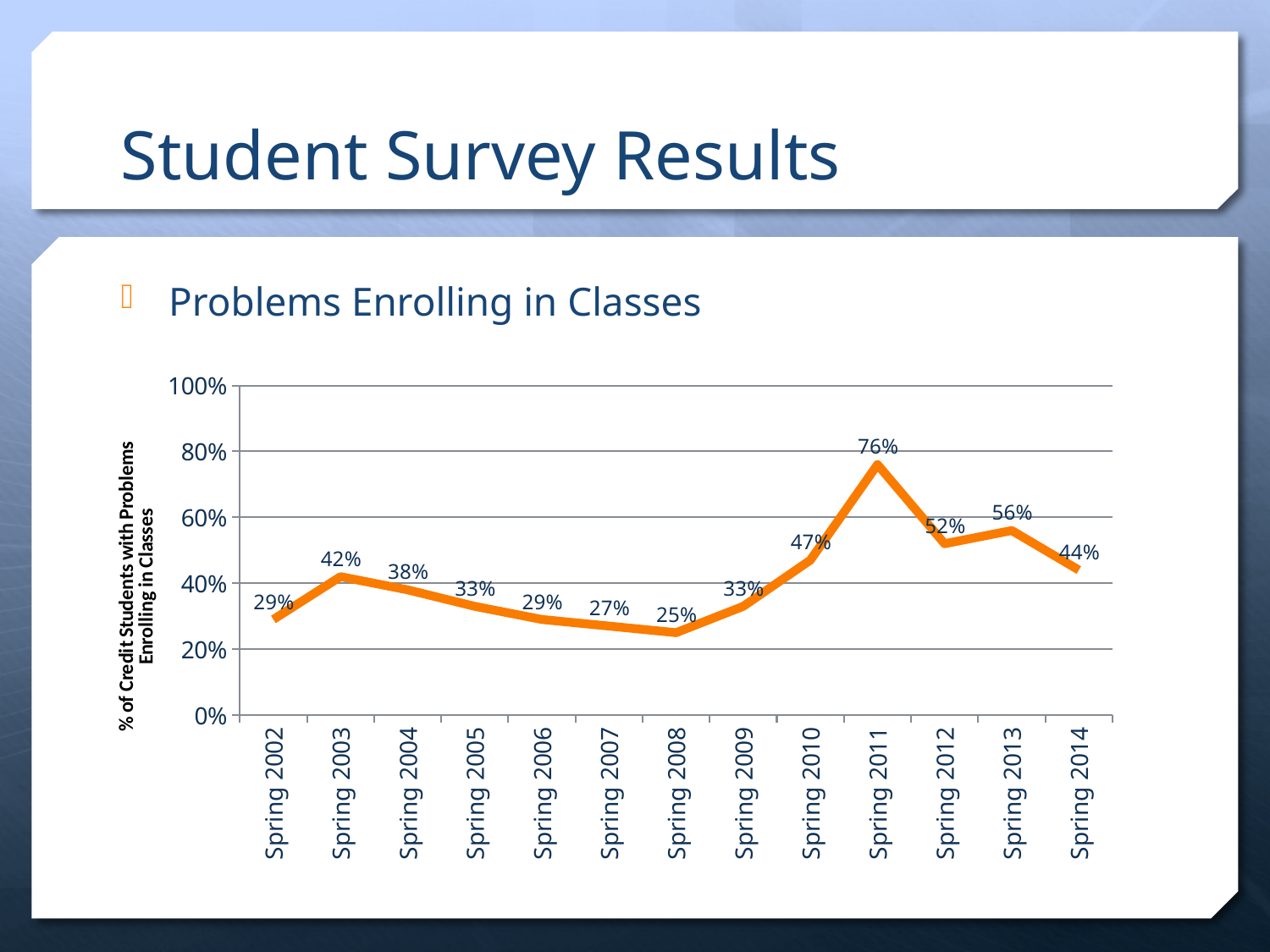
Which is larger, the value for Spring 2003 or the value for Spring 2009? Spring 2003 What is the label on the vertical axis of the chart? % of Credit Students with Problems Enrolling in Classes What kind of chart is shown on the slide? Line chart What is the difference between the values for Spring 2013 and Spring 2014? 12% How many spring terms are plotted on the x axis? 13 Which spring term has the highest percentage of credit students with problems enrolling in classes? Spring 2011 What is the value for Spring 2014? 44% What is the difference between the values for Spring 2011 and Spring 2010? 29% Is the value for Spring 2012 greater or less than 60%? less Which spring term has the lowest percentage of credit students with problems enrolling in classes? Spring 2008 What is the value for Spring 2002? 29% What percentage of credit students reported problems enrolling in classes in Spring 2011? 76%